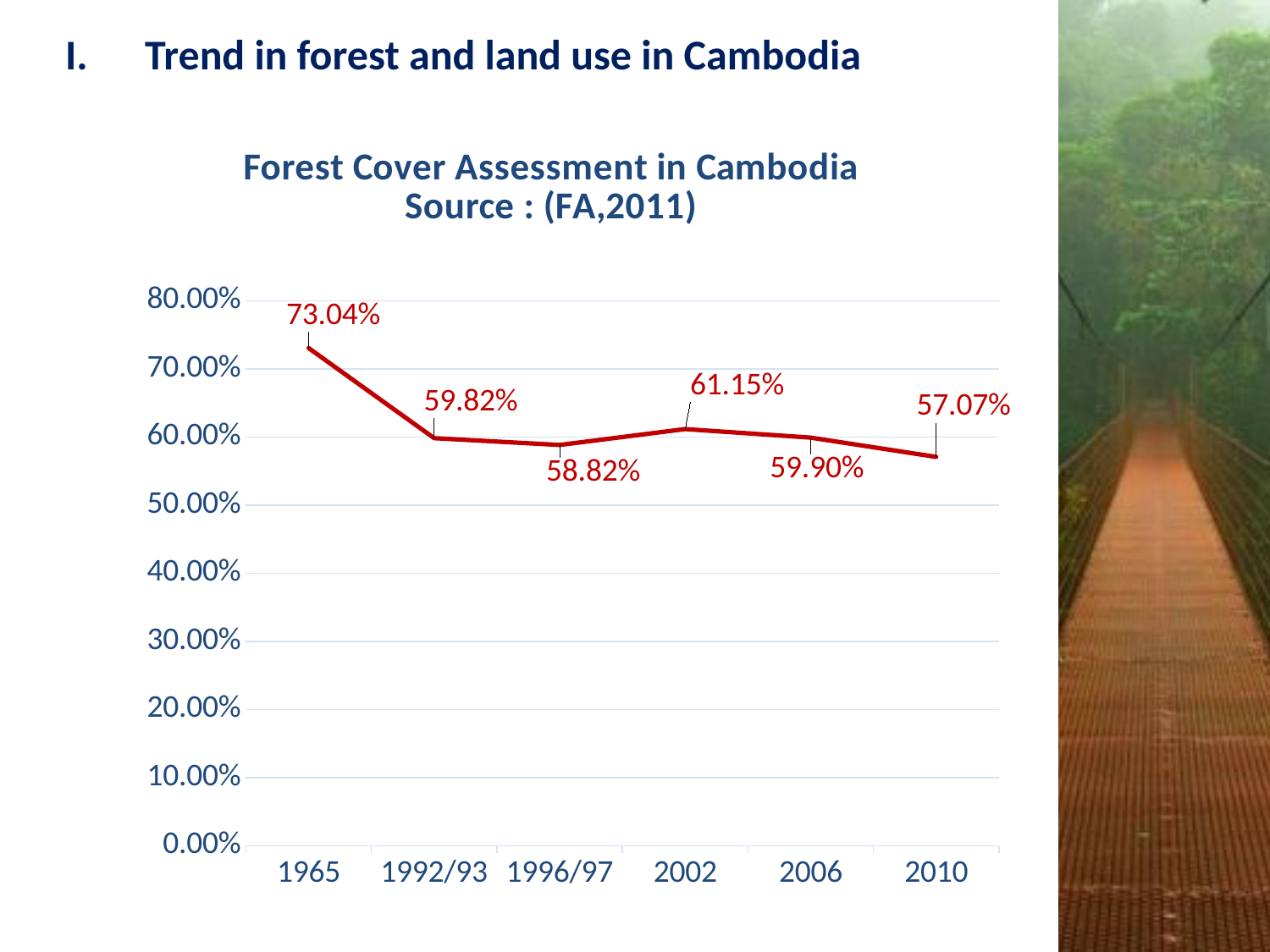
What is the forest cover value for 2010? 57.07% How many data points are plotted on the chart? 6 Which year has the highest forest cover value? 1965 What kind of chart is shown on the slide? line chart Which year has the lowest forest cover value? 2010 What is the forest cover value for 2002? 61.15% Is the forest cover value for 1992/93 greater or less than 70.00%? less Which is larger, the forest cover value for 2002 or for 2006? 2002 What is the forest cover value for 1965? 73.04% What is the forest cover value for 1996/97? 58.82% What is the difference between the forest cover values for 1965 and 2010? 15.97% What is the title of the chart? Forest Cover Assessment in Cambodia Source : (FA,2011)